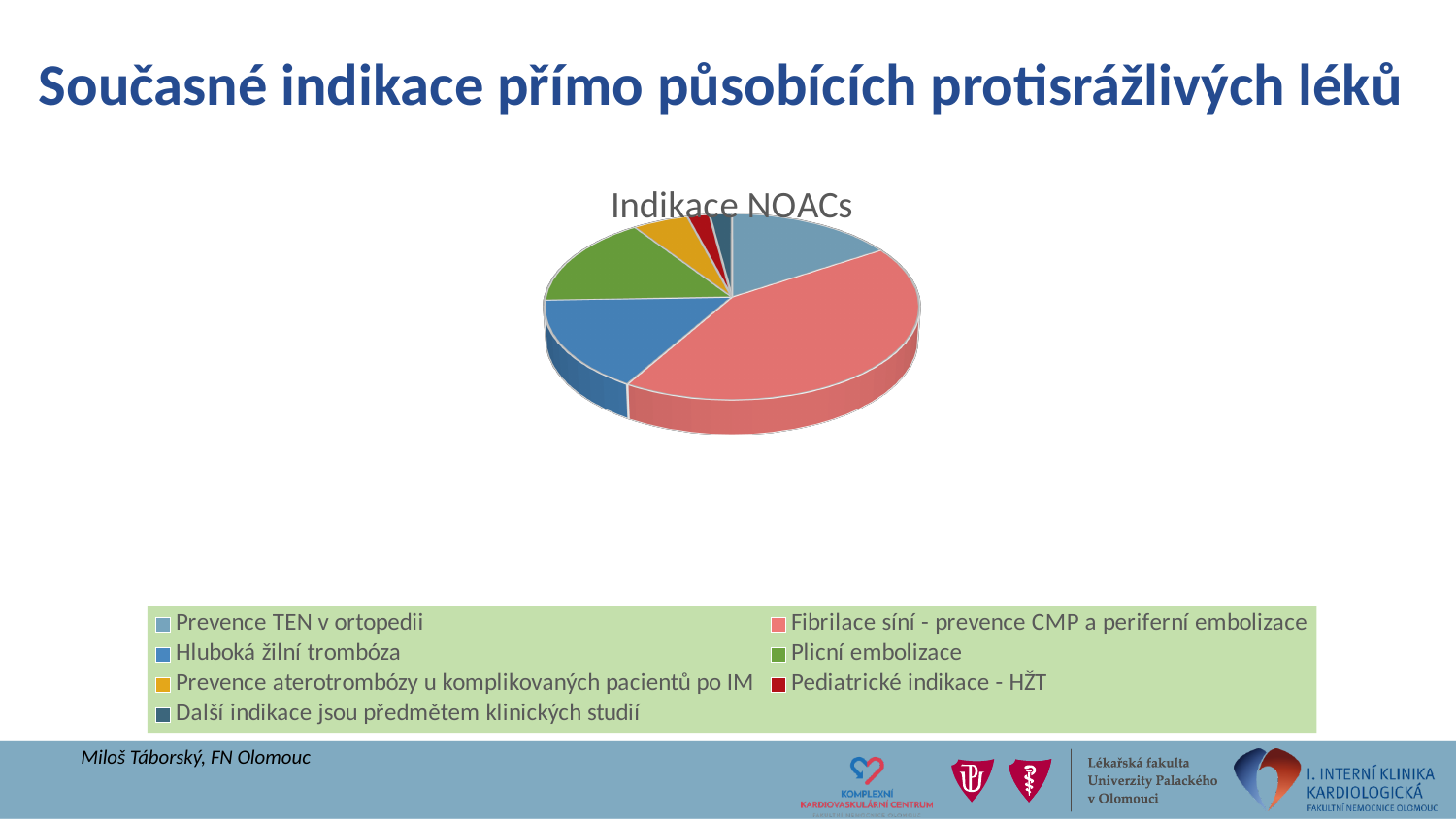
Which slice is larger: Fibrilace síní - prevence CMP a periferní embolizace or Plicní embolizace? Fibrilace síní - prevence CMP a periferní embolizace What kind of chart is shown on the slide? pie chart Which slice is larger: Plicní embolizace or Pediatrické indikace - HŽT? Plicní embolizace Which category has the largest slice of the pie? Fibrilace síní - prevence CMP a periferní embolizace How many categories does the pie chart's legend list? 7 Which slice is larger: Prevence TEN v ortopedii or Další indikace jsou předmětem klinických studií? Prevence TEN v ortopedii What is the title of the chart? Indikace NOACs What colour is the slice for Plicní embolizace? green